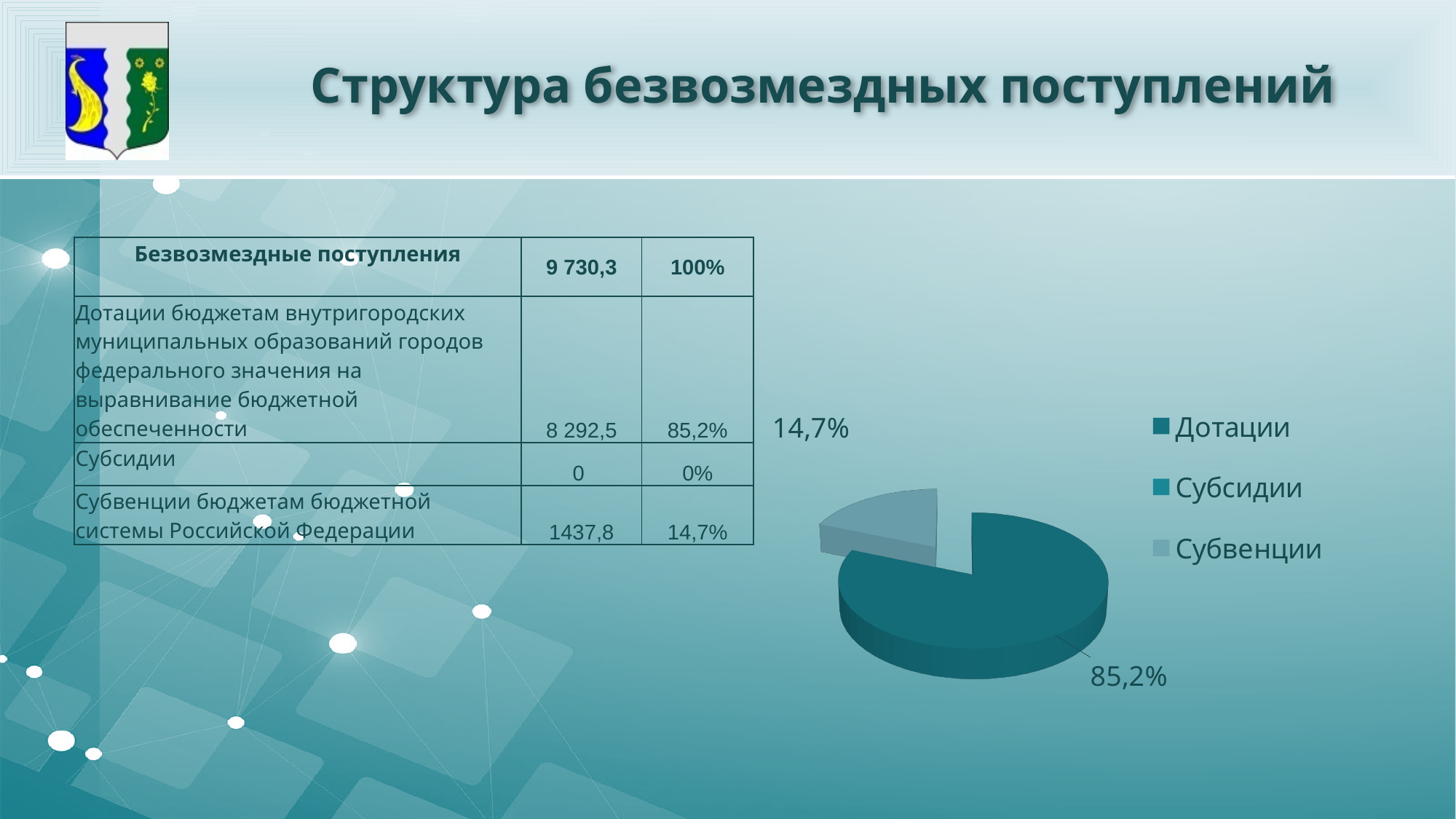
Which legend entry is listed second in the pie chart legend? Субсидии Which of the two labelled slices is larger, Дотации or Субвенции? Дотации Is the share of the Дотации slice greater or less than 50%? greater How many entries does the legend of the pie chart list? 3 What kind of chart is shown on the slide? pie chart What is the title of the slide containing the pie chart? Структура безвозмездных поступлений What share of the pie does the Дотации slice represent? 85,2% Is the share of the Субвенции slice greater or less than 25%? less Which category has the largest slice in the pie chart? Дотации What share of the pie does the Субвенции slice represent? 14,7% How many slices of the pie chart have a percentage data label shown? 2 What is the difference in percentage points between the Дотации slice (85,2%) and the Субвенции slice (14,7%)? 70,5